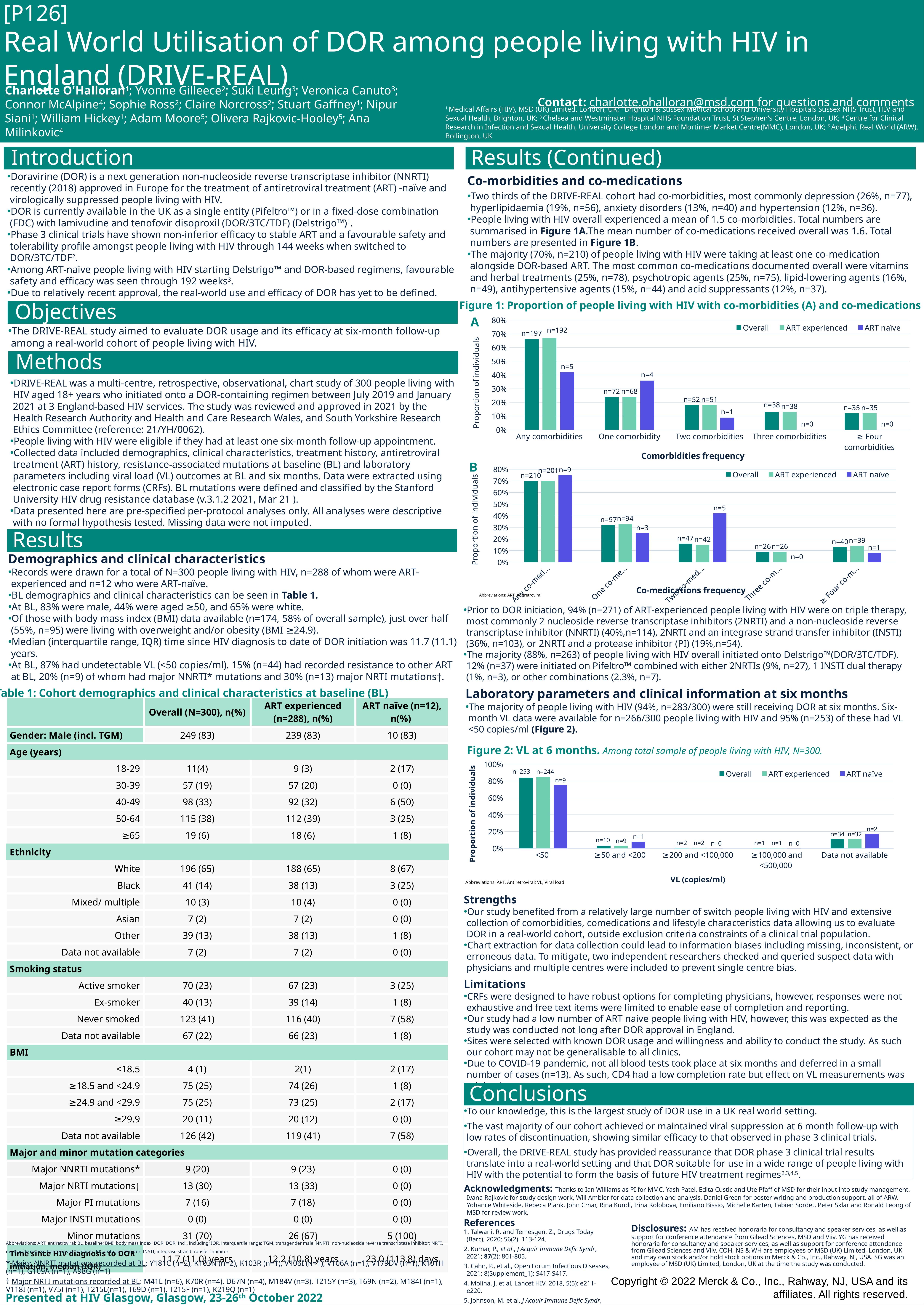
In Figure 2 (VL at 6 months), is the Overall value for '<50' greater or less than 80%? greater In Figure 1A (co-morbidities), how many series does the legend list? 3 In Figure 1B (co-medications), how many categories are shown on the x axis? 5 In Figure 1B (co-medications), what is the n value labelled on the ART naïve bar for 'Two co-medications'? n=5 In Figure 1A (co-morbidities), what is the n value labelled on the ART naïve bar for 'One comorbidity'? n=4 In Figure 1B (co-medications), what kind of chart is shown? bar chart In Figure 2 (VL at 6 months), what is the n value labelled on the Overall bar for '<50'? n=253 In Figure 2 (VL at 6 months), what is the n value labelled on the ART experienced bar for 'Data not available'? n=32 In Figure 1A (co-morbidities), is the Overall value for 'Any comorbidities' greater or less than 60%? greater In Figure 1B (co-medications), what is the n value labelled on the Overall bar for 'Any co-medication'? n=210 In Figure 1A (co-morbidities), what is the n value labelled on the Overall bar for 'Any comorbidities'? n=197 In Figure 2 (VL at 6 months), which VL category has the highest Overall proportion? <50